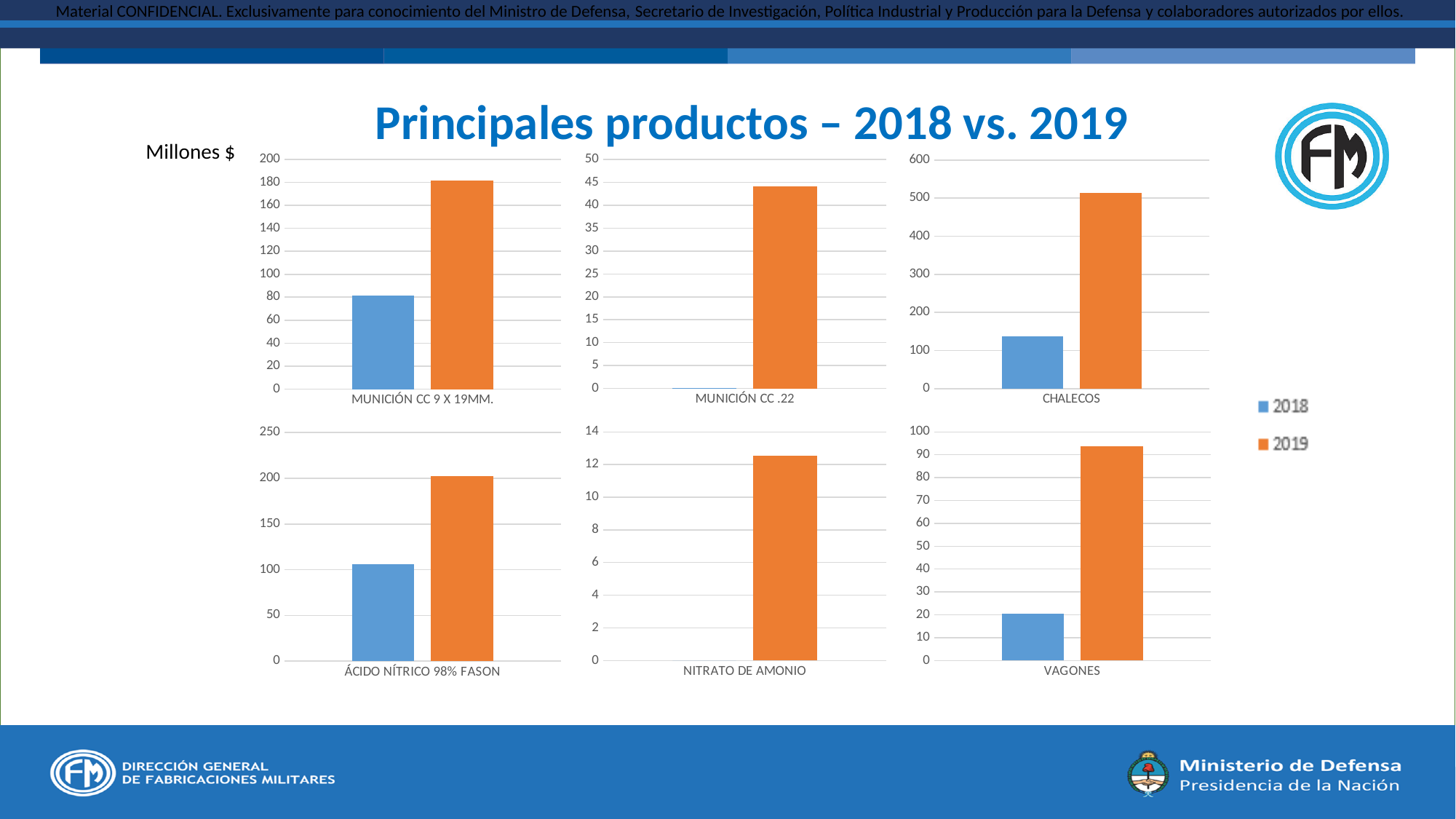
What unit is indicated for the values in the charts? Millones $ In the ÁCIDO NÍTRICO 98% FASON chart, is the value for 2018 greater or less than 150? less In the MUNICIÓN CC .22 chart, is the value for 2019 greater or less than 40? greater In the CHALECOS chart, is the value for 2018 greater or less than 100? greater How many series does the legend list? 2 What kind of chart is used for MUNICIÓN CC 9 X 19MM.? bar chart In the NITRATO DE AMONIO chart, which series has the larger value, 2018 or 2019? 2019 How many separate charts are shown on the slide? 6